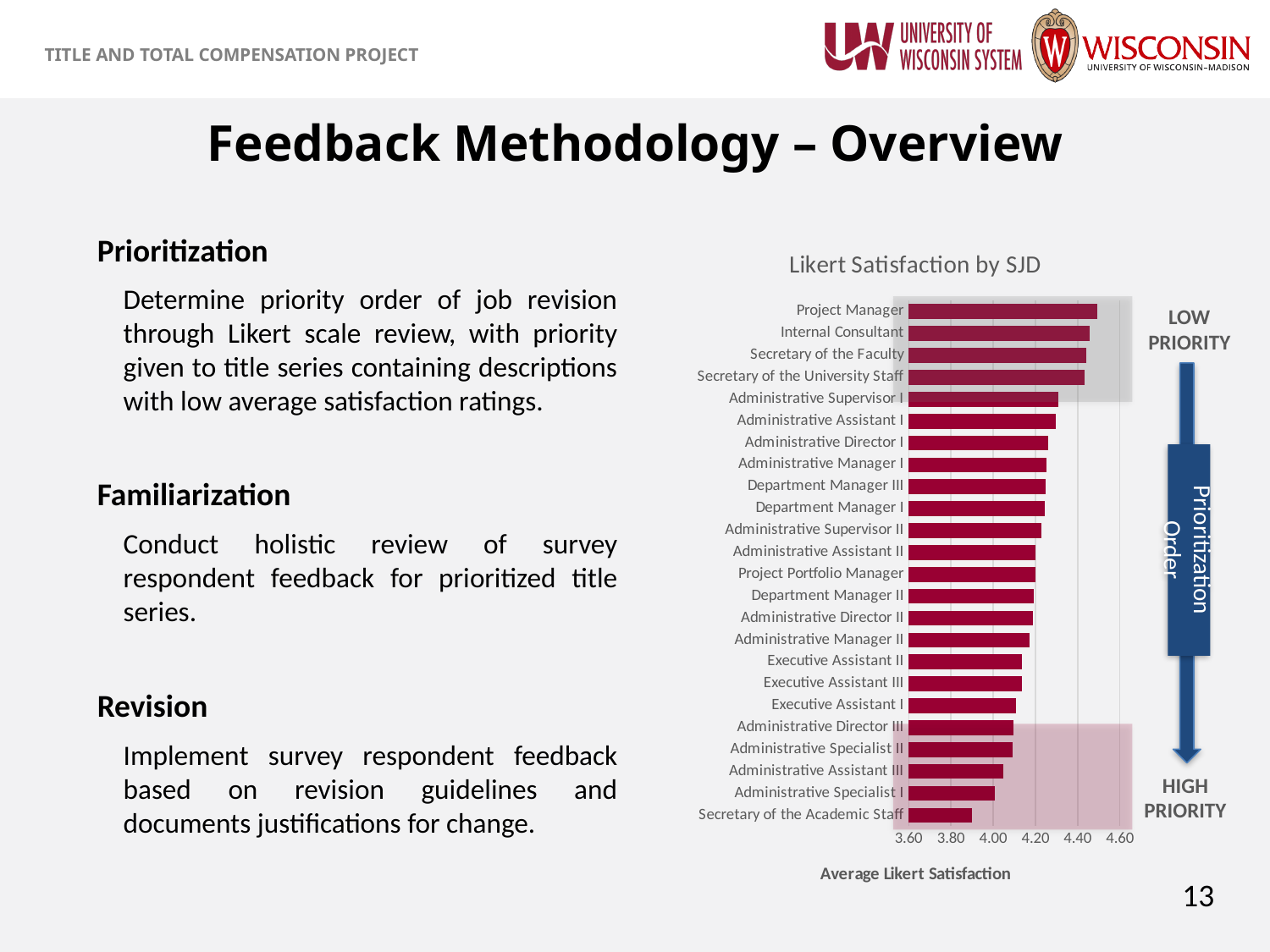
Do the bar values rise or fall going from the top of the chart (Project Manager) to the bottom (Secretary of the Academic Staff)? fall How many job titles (categories) are plotted in the Likert Satisfaction by SJD chart? 24 Is the value for Secretary of the Academic Staff greater or less than 4.00? less Which has a higher average Likert satisfaction, Project Manager or Secretary of the Academic Staff? Project Manager What kind of chart is shown on the slide? bar chart Which job title has the highest average Likert satisfaction in the chart? Project Manager Is the value for Executive Assistant I greater or less than 4.20? less Which job title has the lowest average Likert satisfaction in the chart? Secretary of the Academic Staff Is the value for Administrative Supervisor I greater or less than 4.20? greater What is the title of the chart on the slide? Likert Satisfaction by SJD What is the label on the horizontal axis of the chart? Average Likert Satisfaction